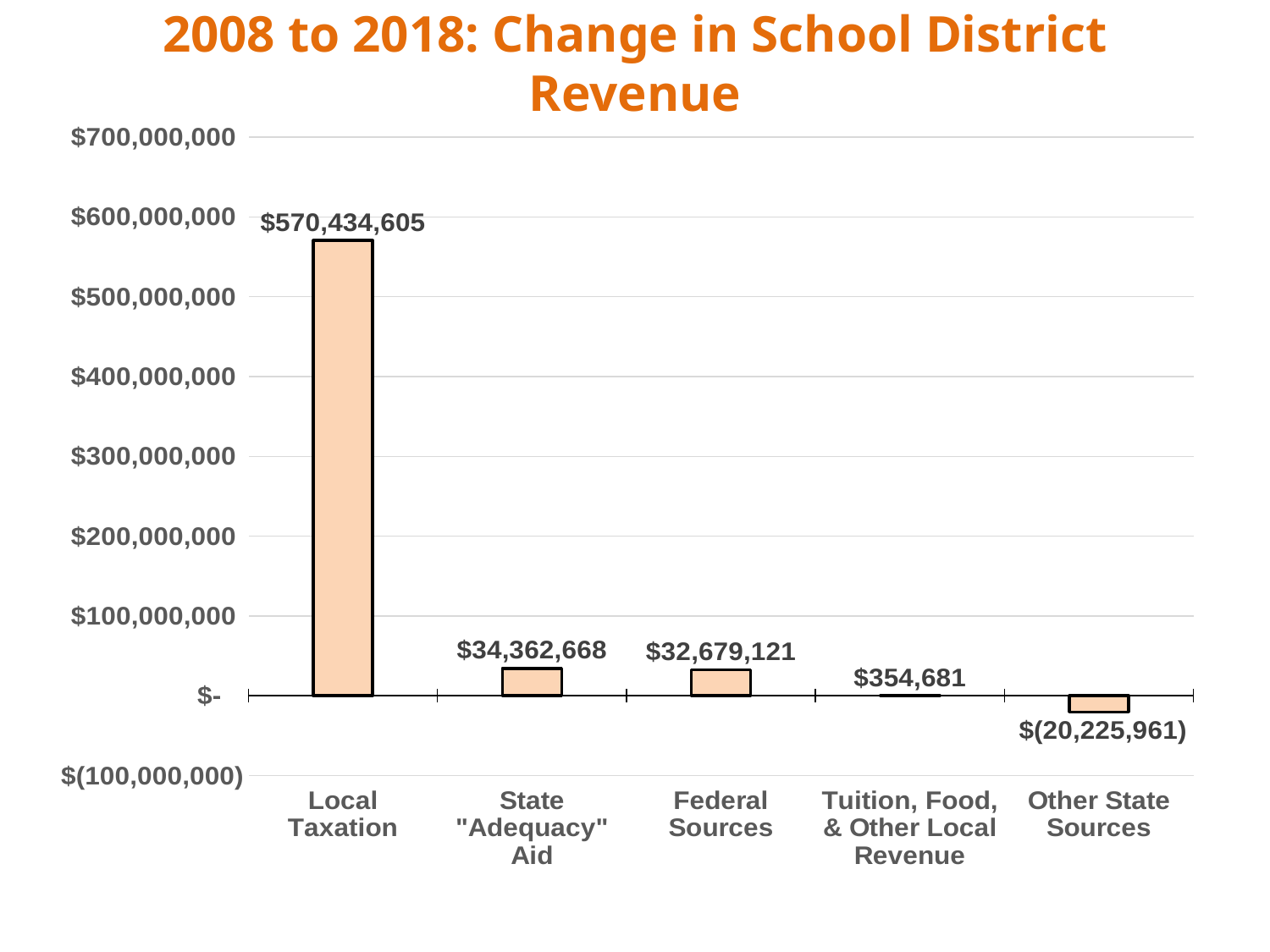
How many categories are shown on the x axis? 5 Which category has the highest value? Local Taxation What is the value for Federal Sources? $32,679,121 Which is larger, the value for Federal Sources or the value for Tuition, Food, & Other Local Revenue? Federal Sources What is the value for Tuition, Food, & Other Local Revenue? $354,681 What is the difference between the values for State "Adequacy" Aid and Federal Sources? $1,683,547 Is the value for Local Taxation greater or less than $500,000,000? greater What kind of chart is shown on the slide? Bar chart What is the value for State "Adequacy" Aid? $34,362,668 What is the value for Local Taxation? $570,434,605 Which category has the lowest value? Other State Sources What is the value for Other State Sources? $(20,225,961)